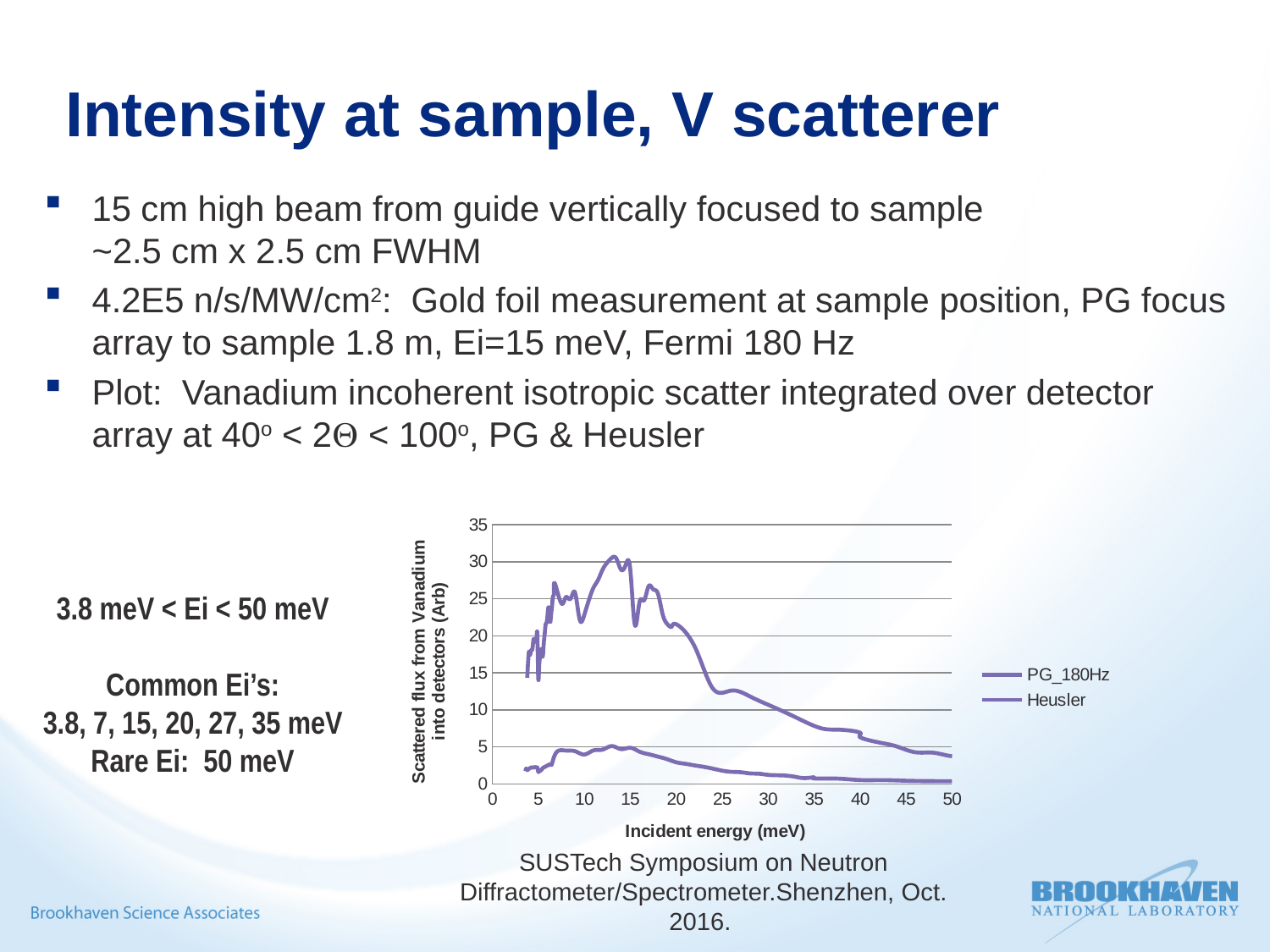
What is the title of the x axis of the chart? Incident energy (meV) At 15 meV, which line has the larger value, the upper line or the lower line? the upper line What are the two series names listed in the chart legend? PG_180Hz and Heusler Is the value of the upper line at 45 meV greater or less than 10? less How many series does the chart legend list? 2 What kind of chart is shown on the slide? line chart Does the upper line rise or fall as incident energy increases from 30 meV to 50 meV? fall Is the value of the upper line at 40 meV greater or less than 5? greater Is the value of the lower line at 15 meV greater or less than 10? less Does the lower line rise or fall as incident energy increases from 20 meV to 50 meV? fall